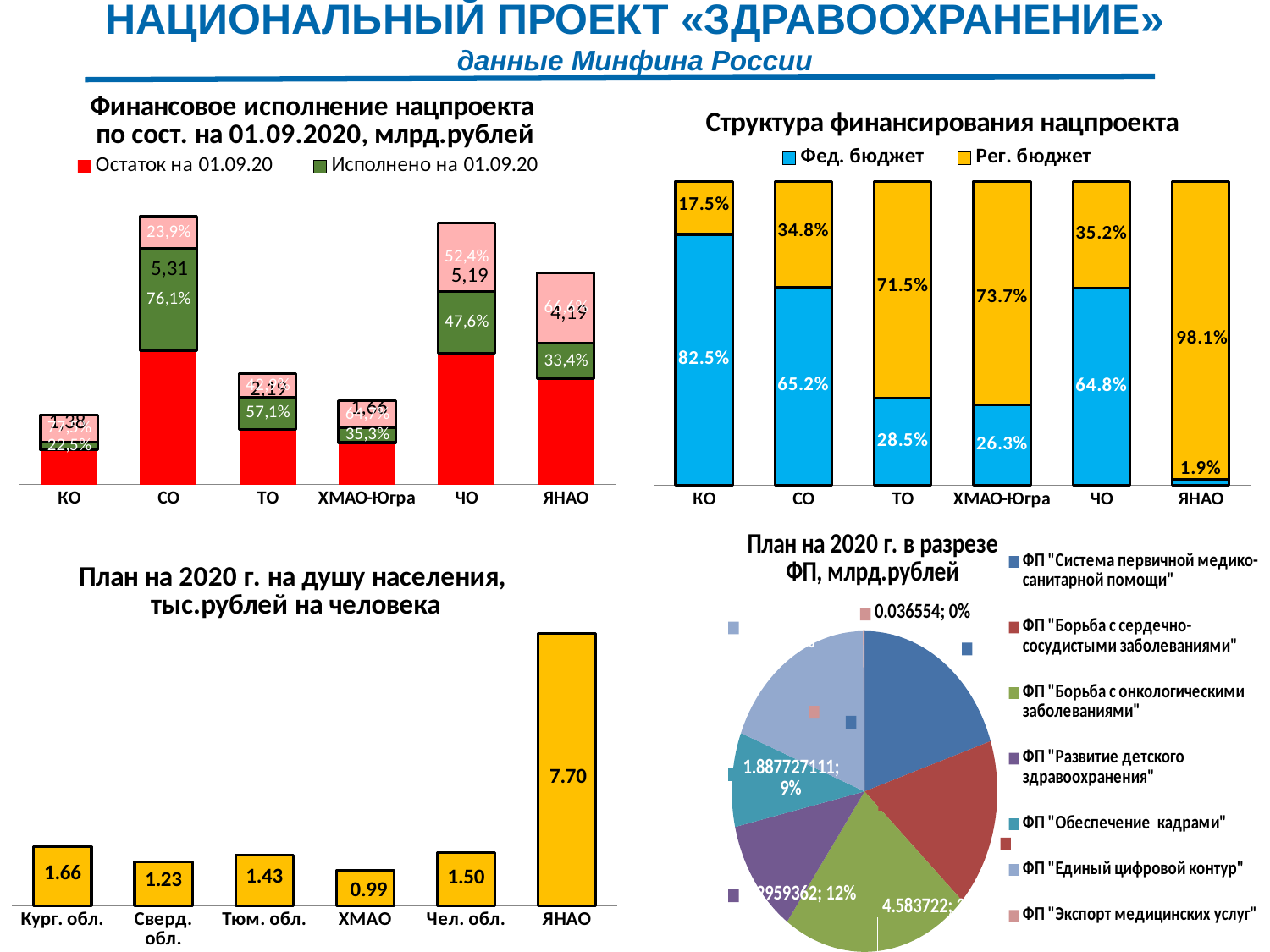
In the chart 'План на 2020 г. на душу населения, тыс.рублей на человека', what is the value for ЯНАО? 7.70 What kind of chart is 'План на 2020 г. в разрезе ФП, млрд.рублей'? pie chart In the chart 'План на 2020 г. на душу населения, тыс.рублей на человека', what is the difference between Кург. обл. and Сверд. обл.? 0.43 In the chart 'Структура финансирования нацпроекта', how many series does the legend list? 2 In the chart 'Финансовое исполнение нацпроекта по сост. на 01.09.2020, млрд.рублей', what percentage is shown on the green (Исполнено) segment for СО? 76,1% In the chart 'План на 2020 г. на душу населения, тыс.рублей на человека', how many regions are shown? 6 In the chart 'Структура финансирования нацпроекта', which region has the highest share of Рег. бюджет? ЯНАО In the chart 'Структура финансирования нацпроекта', which region has the lowest share of Фед. бюджет? ЯНАО In the chart 'План на 2020 г. на душу населения, тыс.рублей на человека', which region has the lowest value? ХМАО In the chart 'Структура финансирования нацпроекта', what is the share of Рег. бюджет for ЯНАО? 98.1% In the chart 'Структура финансирования нацпроекта', what is the share of Фед. бюджет for КО? 82.5% In the chart 'Структура финансирования нацпроекта', what is the difference between the Рег. бюджет shares of ХМАО-Югра and ТО? 2.2%